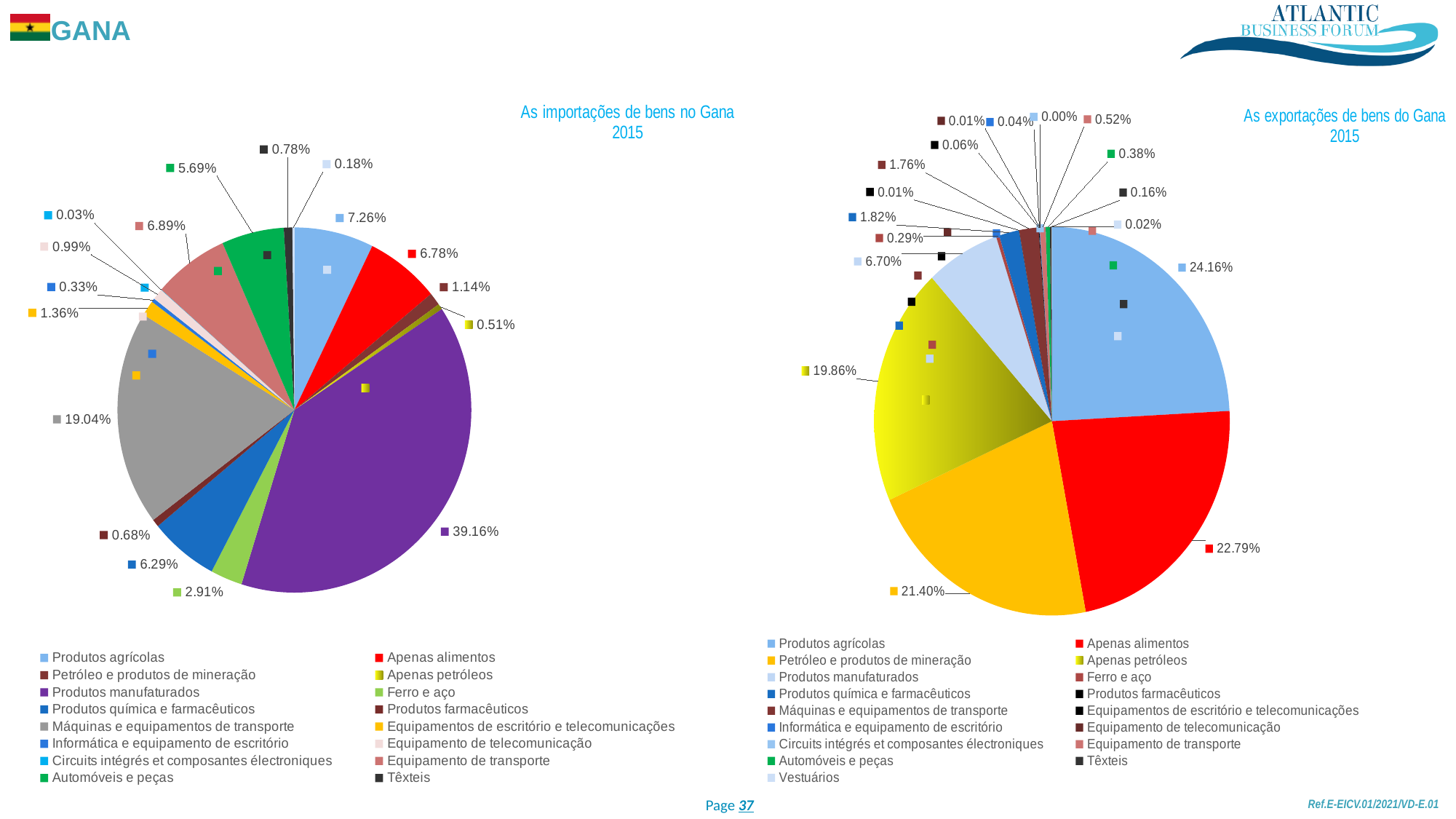
In the chart 'As importações de bens no Gana 2015', which category has the largest share? Produtos manufaturados How many entries does the legend of the chart 'As exportações de bens do Gana 2015' list? 17 In the chart 'As exportações de bens do Gana 2015', which category has the largest share? Produtos agrícolas In the chart 'As importações de bens no Gana 2015', what share do Máquinas e equipamentos de transporte have? 19.04% In the chart 'As importações de bens no Gana 2015', which is larger: Equipamento de transporte or Automóveis e peças? Equipamento de transporte In the chart 'As exportações de bens do Gana 2015', what share do Produtos agrícolas have? 24.16% In the chart 'As exportações de bens do Gana 2015', what share does Petróleo e produtos de mineração have? 21.40% In the chart 'As importações de bens no Gana 2015', what share do Produtos manufaturados have? 39.16% What type of charts are shown on the slide? Pie charts In the chart 'As exportações de bens do Gana 2015', what is the difference between the shares of Apenas alimentos and Apenas petróleos? 2.93% What is the title of the pie chart on the left of the slide? As importações de bens no Gana 2015 In the chart 'As importações de bens no Gana 2015', what is the difference between the shares of Produtos agrícolas and Apenas alimentos? 0.48%